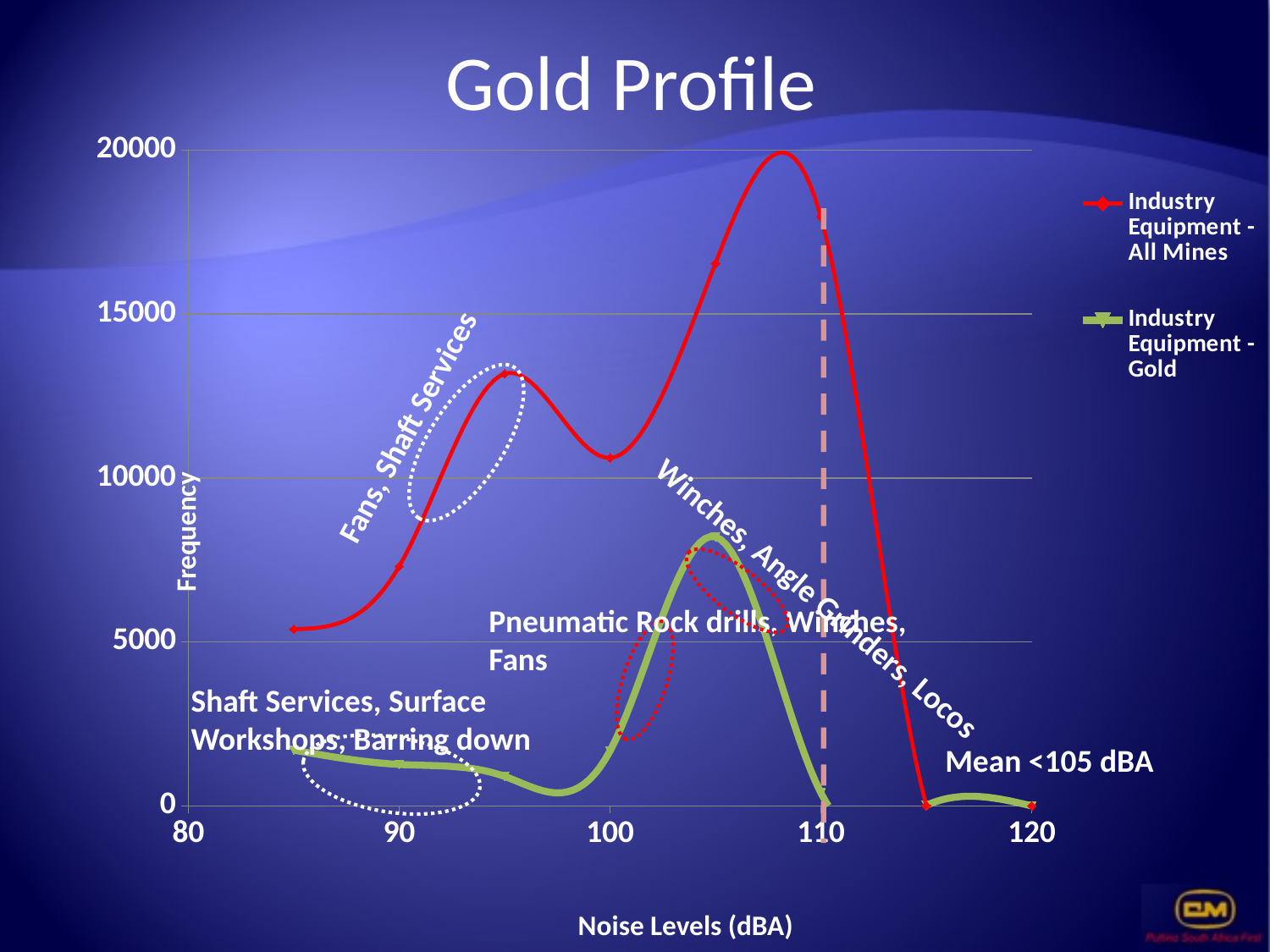
Is the value of the Industry Equipment - All Mines series at 95 dBA greater or less than 10000? greater What type of chart is shown on the slide? line chart Does the Industry Equipment - All Mines series rise or fall between 110 and 115 dBA? fall What is the label of the x axis? Noise Levels (dBA) At 105 dBA, which series has the higher value: Industry Equipment - All Mines or Industry Equipment - Gold? Industry Equipment - All Mines Is the value of the Industry Equipment - Gold series at 90 dBA greater or less than 5000? less Is the value of the Industry Equipment - All Mines series at 110 dBA greater or less than 15000? greater How many series does the legend list? 2 At which noise level does the Industry Equipment - Gold series reach its highest value? 105 What is the title of the chart? Gold Profile Does the Industry Equipment - Gold series rise or fall between 100 and 105 dBA? rise